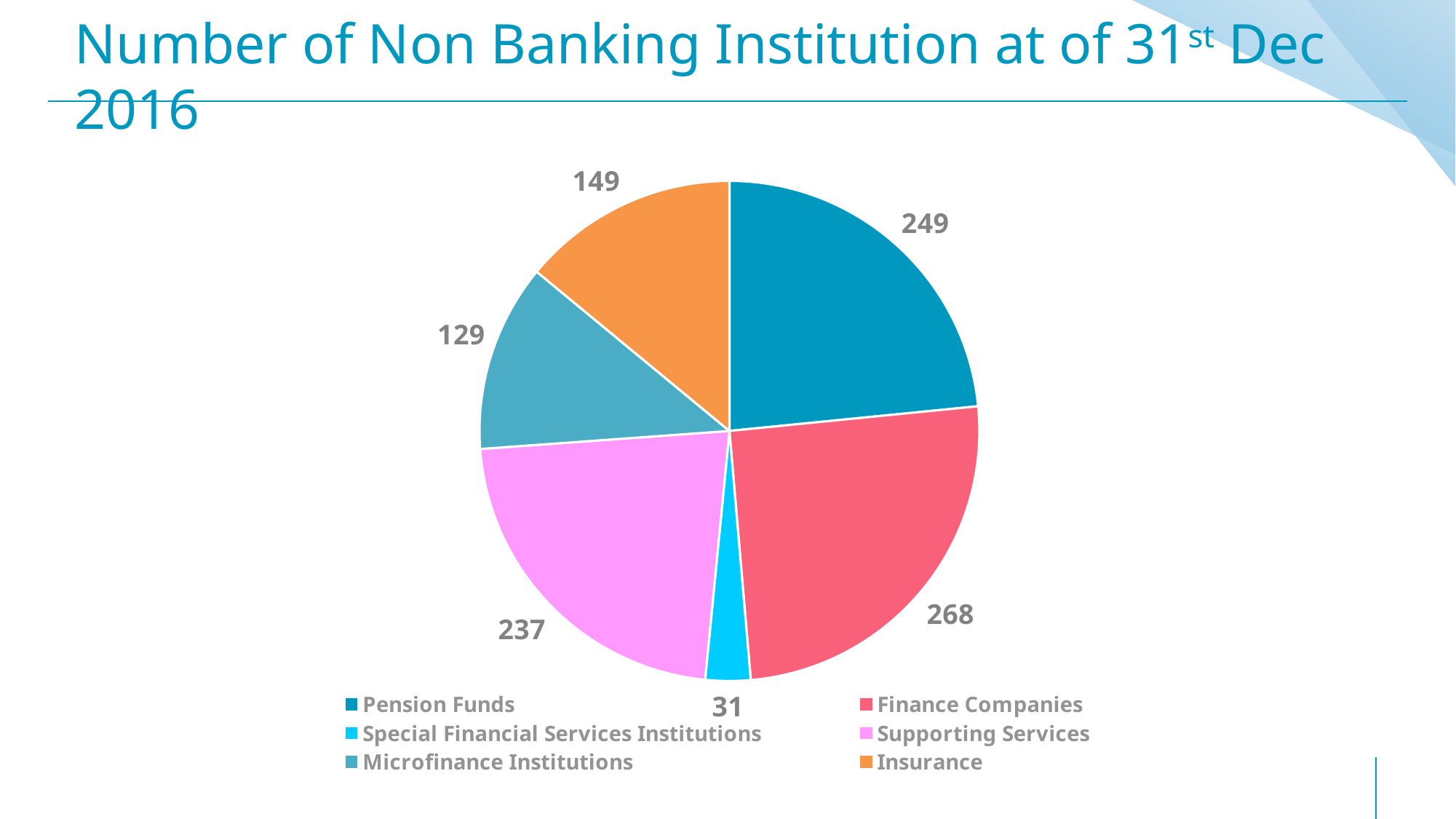
How many more Finance Companies are there than Pension Funds? 19 What kind of chart is shown on the slide? Pie chart Which is larger, Insurance or Microfinance Institutions? Insurance Which category has the smallest slice of the pie? Special Financial Services Institutions What is the value for Microfinance Institutions? 129 What is the value for Supporting Services? 237 What is the value for Finance Companies? 268 Which category has the largest slice of the pie? Finance Companies What is the value for Insurance? 149 How many Pension Funds are shown in the pie chart? 249 How many categories does the pie chart show? 6 What is the value for Special Financial Services Institutions? 31